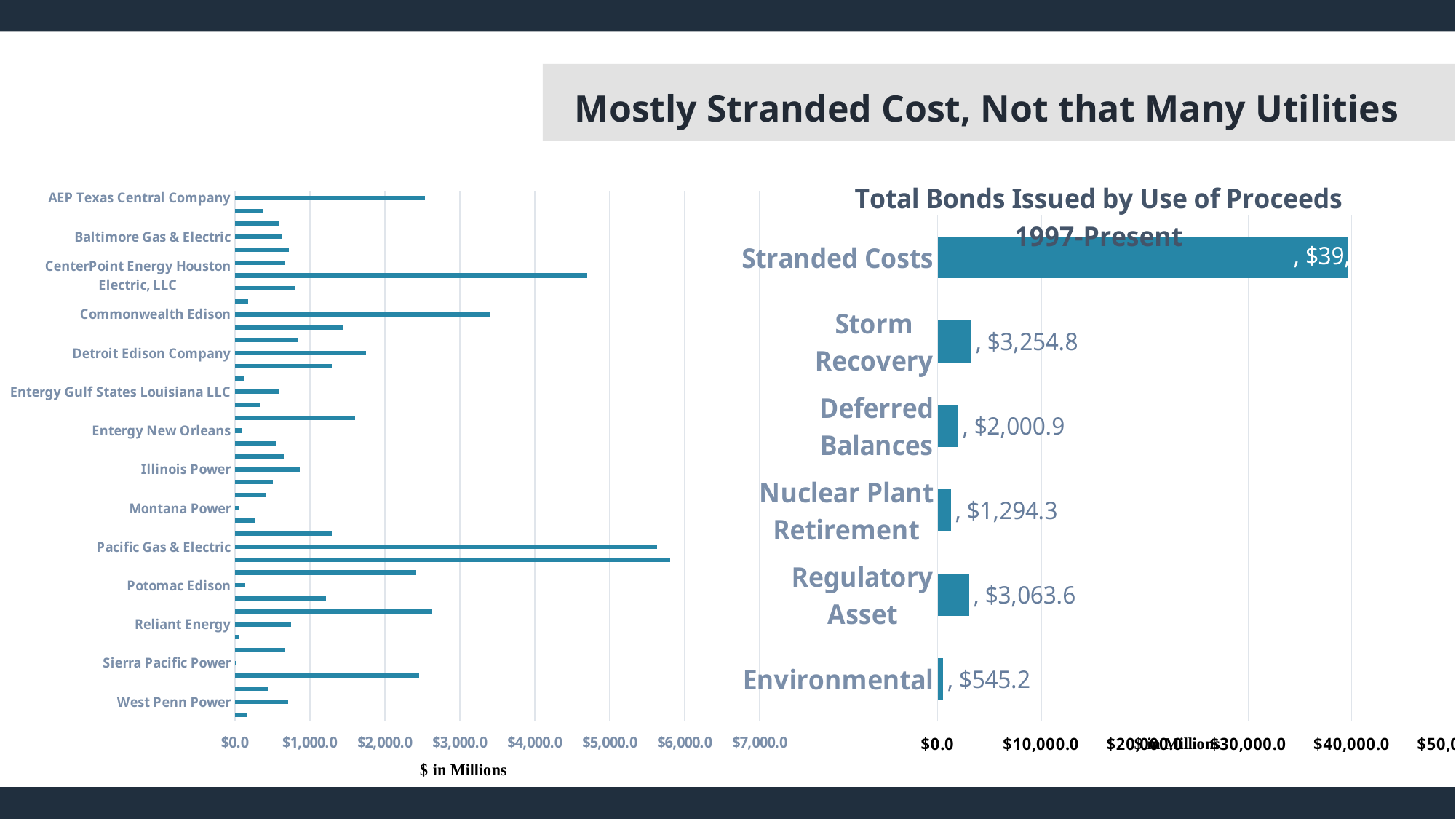
How many categories are shown in the chart titled 'Total Bonds Issued by Use of Proceeds 1997-Present'? 6 In the chart on the left side of the slide, is the value for Montana Power greater or less than $1,000.0? less In the chart titled 'Total Bonds Issued by Use of Proceeds 1997-Present', what is the value for Nuclear Plant Retirement? $1,294.3 In the chart titled 'Total Bonds Issued by Use of Proceeds 1997-Present', which is larger, Deferred Balances or Nuclear Plant Retirement? Deferred Balances In the chart titled 'Total Bonds Issued by Use of Proceeds 1997-Present', which category has the highest value? Stranded Costs In the chart on the left side of the slide, is the value for Commonwealth Edison greater or less than $3,000.0? greater In the chart on the left side of the slide, is the value for Pacific Gas & Electric greater or less than $5,000.0? greater What kind of chart is the chart on the left side of the slide? Bar chart In the chart titled 'Total Bonds Issued by Use of Proceeds 1997-Present', what is the value for Environmental? $545.2 In the chart titled 'Total Bonds Issued by Use of Proceeds 1997-Present', which category has the lowest value? Environmental In the chart titled 'Total Bonds Issued by Use of Proceeds 1997-Present', what is the value for Storm Recovery? $3,254.8 In the chart titled 'Total Bonds Issued by Use of Proceeds 1997-Present', what is the difference between Storm Recovery and Regulatory Asset? $191.2